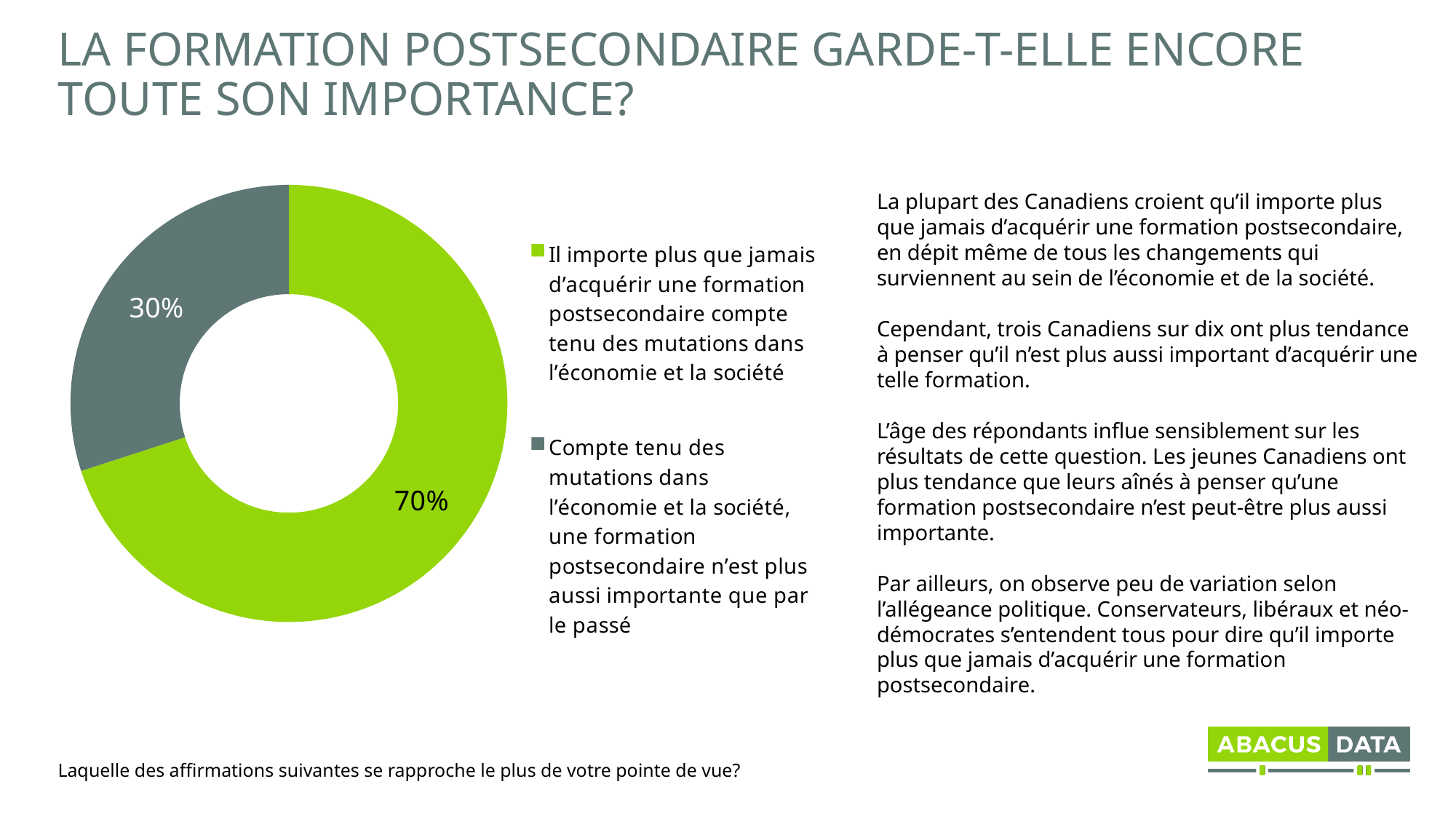
How many slices does the pie chart have? 2 Which response has the largest share of the pie? Il importe plus que jamais d'acquérir une formation postsecondaire compte tenu des mutations dans l'économie et la société Which response has the smallest share of the pie? Compte tenu des mutations dans l'économie et la société, une formation postsecondaire n'est plus aussi importante que par le passé What colour is the slice labelled 30%? Grey Which slice is larger: the one for "Il importe plus que jamais" or the one for "n'est plus aussi importante que par le passé"? Il importe plus que jamais What colour is the slice labelled 70%? Green How many entries does the legend list? 2 What kind of chart is shown on the slide? Pie chart (doughnut) What is the total of the two slices shown in the pie chart? 100% What is the difference in percentage points between the two slices of the pie? 40 percentage points What share of respondents say a postsecondary education is no longer as important as in the past ("Compte tenu des mutations... n'est plus aussi importante que par le passé")? 30% What share of respondents say it is more important than ever to obtain a postsecondary education ("Il importe plus que jamais d'acquérir une formation postsecondaire...")? 70%